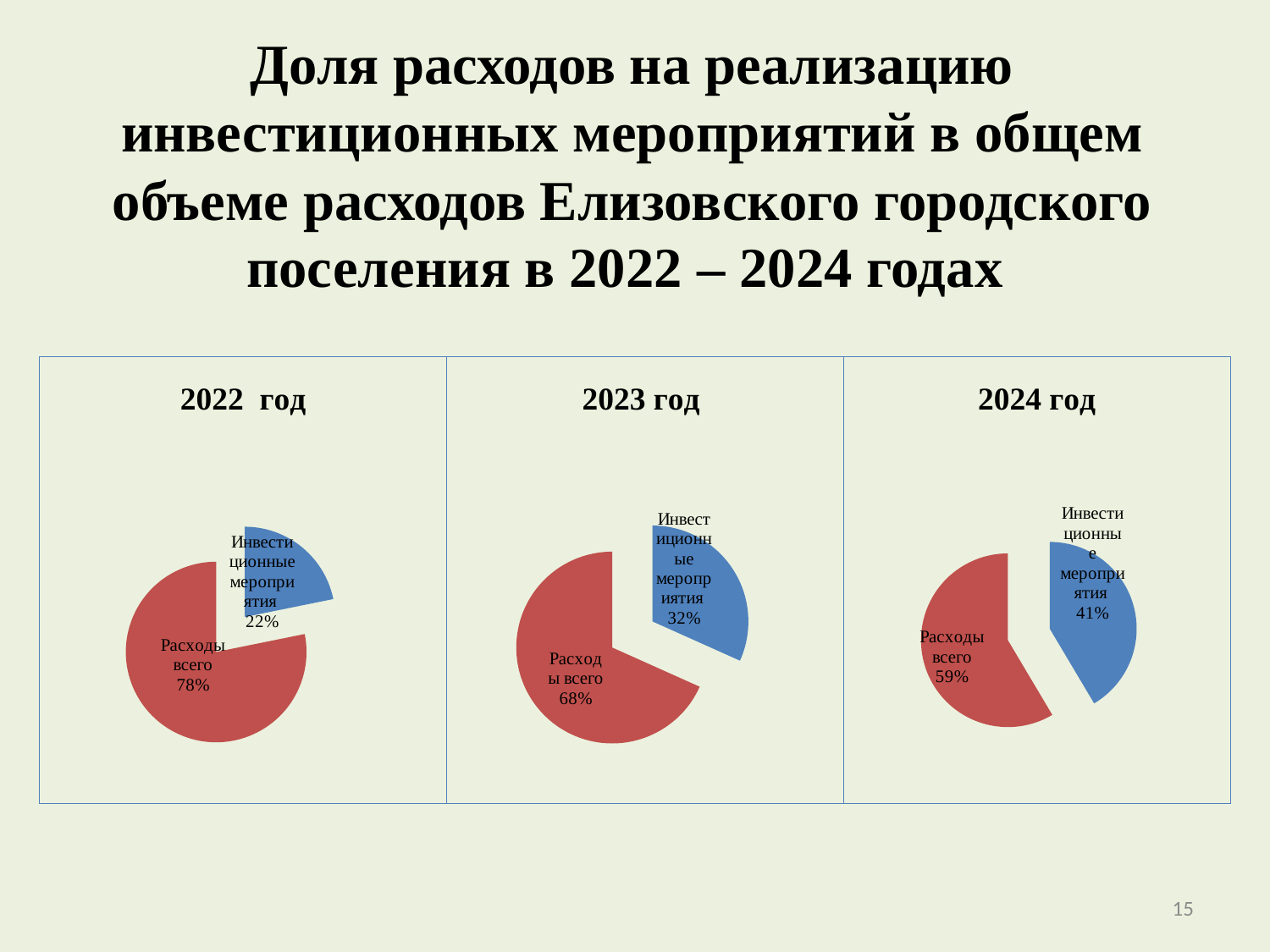
In the 2024 год chart, which slice is larger, Расходы всего or Инвестиционные мероприятия? Расходы всего In the 2024 год chart, what share is labelled for Инвестиционные мероприятия? 41% In the 2022 год chart, what share is labelled for Расходы всего? 78% In the 2023 год chart, what share is labelled for Расходы всего? 68% How many slices does the 2023 год pie chart have? 2 Across the three charts, in which year is the share of Инвестиционные мероприятия the lowest? 2022 год What is the difference between the Инвестиционные мероприятия share in the 2024 год chart and in the 2022 год chart? 19% What kind of chart is used for each year on the slide? Pie chart Across the three charts, in which year is the share of Инвестиционные мероприятия the highest? 2024 год